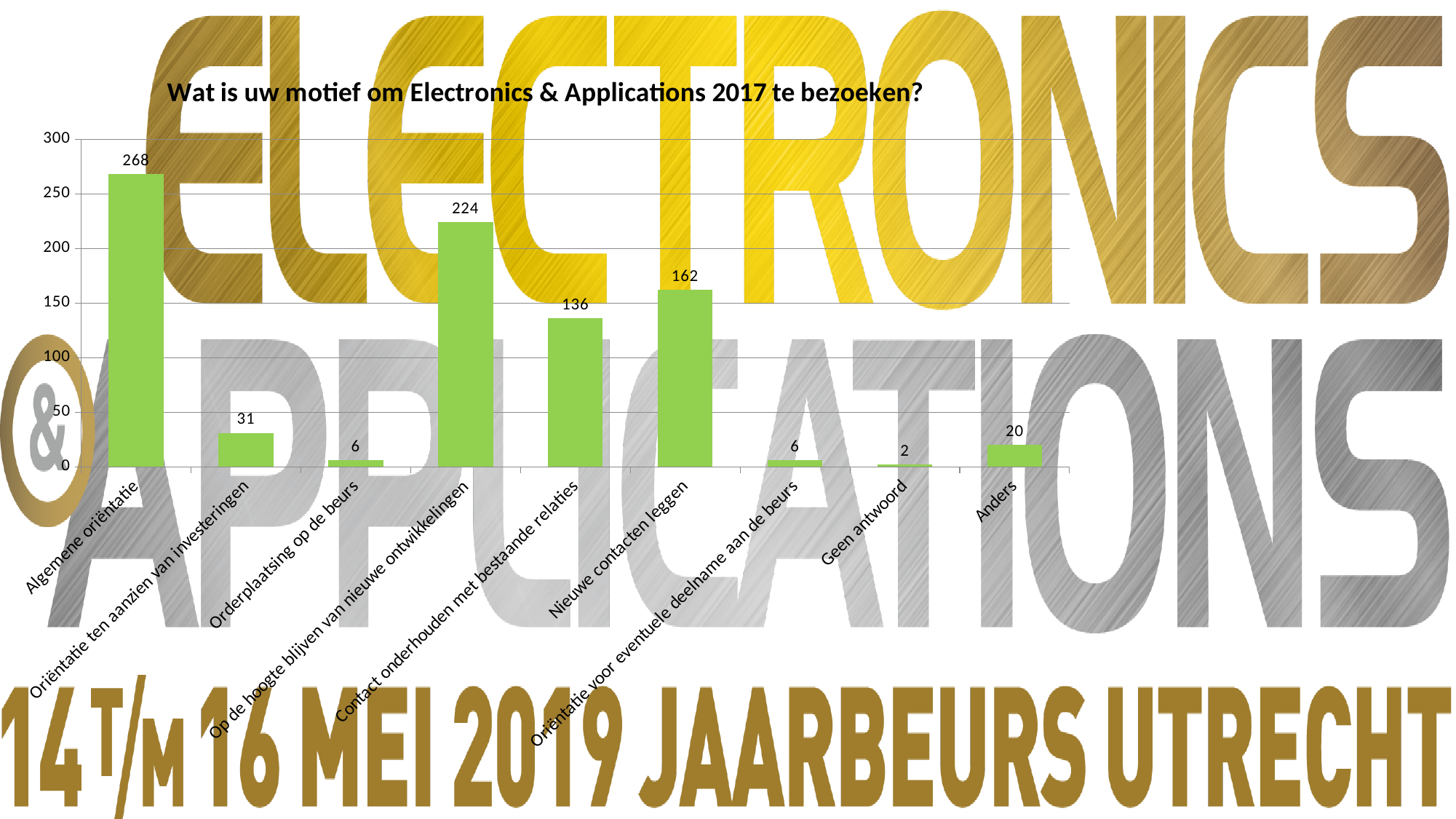
What kind of chart is shown on the slide? bar chart What is the title of the chart? Wat is uw motief om Electronics & Applications 2017 te bezoeken? What is the value for 'Contact onderhouden met bestaande relaties'? 136 How many categories are shown in the chart? 9 What is the difference between 'Algemene oriëntatie' and 'Op de hoogte blijven van nieuwe ontwikkelingen'? 44 Is the value for 'Op de hoogte blijven van nieuwe ontwikkelingen' greater or less than 200? greater What is the value for 'Nieuwe contacten leggen'? 162 Which category has the lowest value? Geen antwoord What is the value for 'Algemene oriëntatie'? 268 Which category has the highest value? Algemene oriëntatie What is the value for 'Anders'? 20 Which is larger: 'Nieuwe contacten leggen' or 'Contact onderhouden met bestaande relaties'? Nieuwe contacten leggen